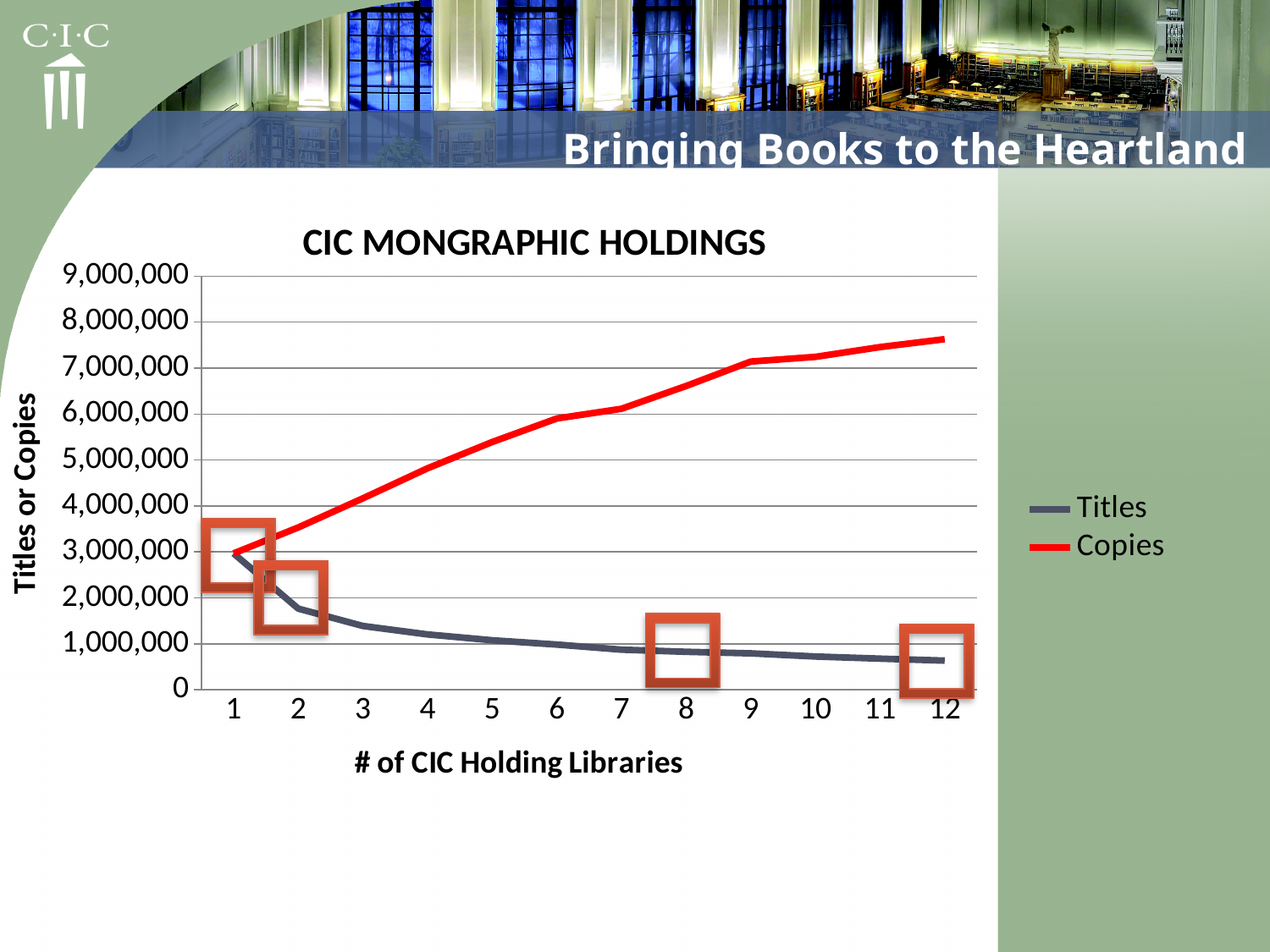
How many points along the x axis (# of CIC Holding Libraries) does each line cover? 12 How many series does the legend list? 2 At 12 holding libraries, which series has the larger value, Titles or Copies? Copies Is the Copies value at 12 holding libraries greater or less than 7,000,000? greater Does the Titles line rise or fall as the number of CIC holding libraries increases? falls At which number of CIC holding libraries is the Titles value lowest? 12 What is the title of the chart? CIC MONGRAPHIC HOLDINGS What kind of chart is shown on the slide? line chart Is the Titles value at 12 holding libraries greater or less than 1,000,000? less Does the Copies line rise or fall as the number of CIC holding libraries increases? rises Is the Copies value at 6 holding libraries greater or less than 5,000,000? greater At which number of CIC holding libraries is the Copies value highest? 12